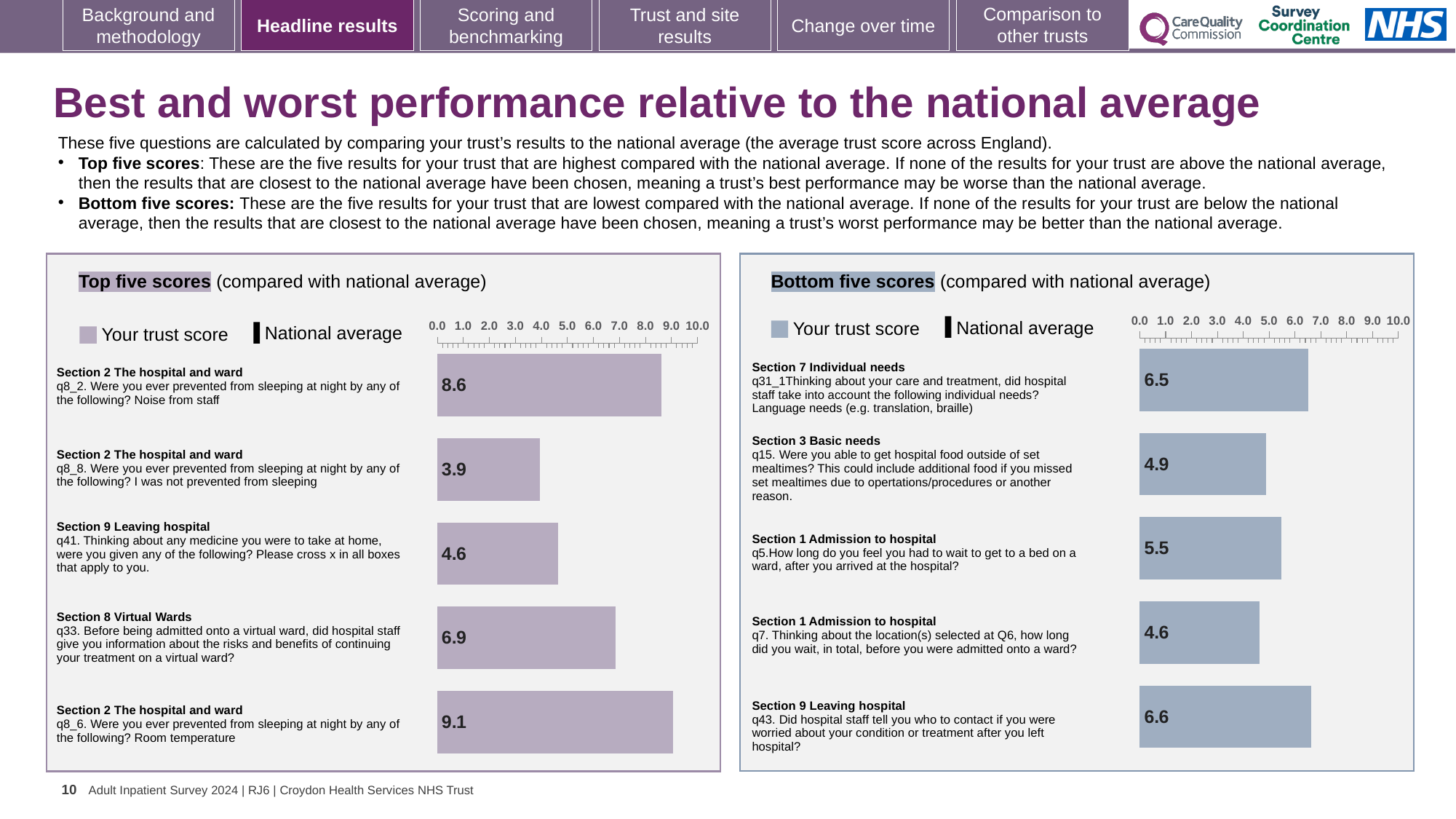
In the Top five scores chart, what is the trust score for q8_6 (Room temperature)? 9.1 In the Bottom five scores chart, what is the trust score for q15 (hospital food outside of set mealtimes)? 4.9 In the Bottom five scores chart, what is the trust score for q43 (who to contact after leaving hospital)? 6.6 What type of chart is used in the Top five scores panel? Bar chart In the Bottom five scores chart, which question has the lowest trust score? q7 (wait before admitted onto a ward) How many bars are shown in the Bottom five scores chart? 5 In the Bottom five scores chart, which has the larger trust score, q5 or q15? q5 In the Top five scores chart, what is the trust score for q33 (virtual ward information)? 6.9 In the Top five scores chart, what is the difference between the trust scores for q8_6 and q8_2? 0.5 In the Top five scores chart, which question has the highest trust score? q8_6 (Room temperature) In the Top five scores chart, which question has the lowest trust score? q8_8 (I was not prevented from sleeping) In the Bottom five scores chart, what is the difference between the trust scores for q31_1 and q5? 1.0